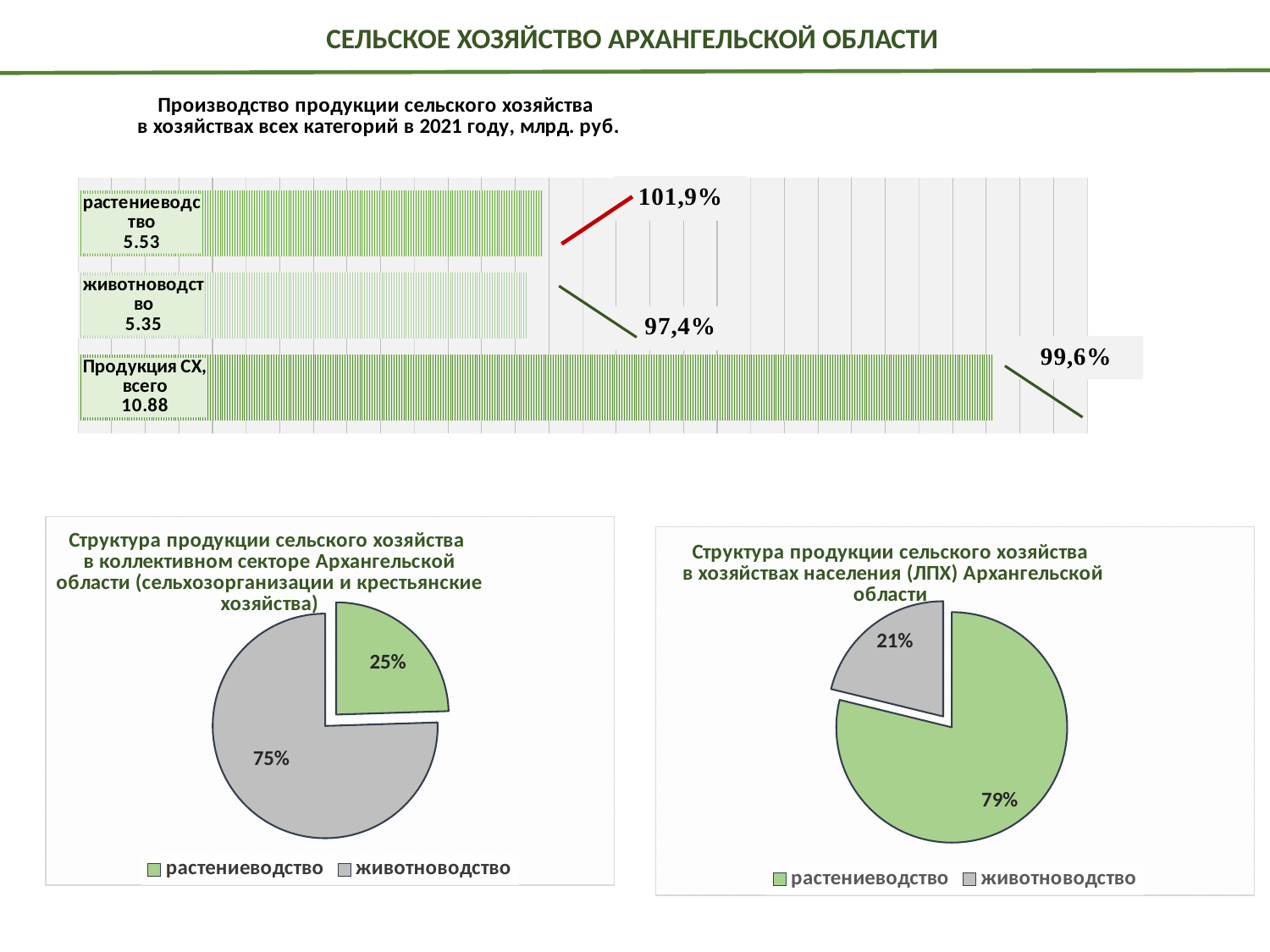
What kind of chart is the top chart on the slide? Bar chart In the top bar chart, what is the difference between the values for растениеводство and животноводство? 0.18 In the bottom-right pie chart (хозяйства населения (ЛПХ)), what share does растениеводство have? 79% In the top bar chart, what is the value for животноводство? 5.35 How many series does the legend of the bottom-right pie chart list? 2 In the top bar chart, what percentage is shown next to the животноводство bar? 97,4% In the top bar chart, which category has the largest value? Продукция СХ, всего In the top bar chart, what is the value for Продукция СХ, всего? 10.88 In the top bar chart, what percentage is shown next to the растениеводство bar? 101,9% In the top bar chart, how many bars are plotted? 3 In the top bar chart 'Производство продукции сельского хозяйства в хозяйствах всех категорий в 2021 году', what is the value for растениеводство? 5.53 In the bottom-left pie chart (коллективный сектор), what share does животноводство have? 75%